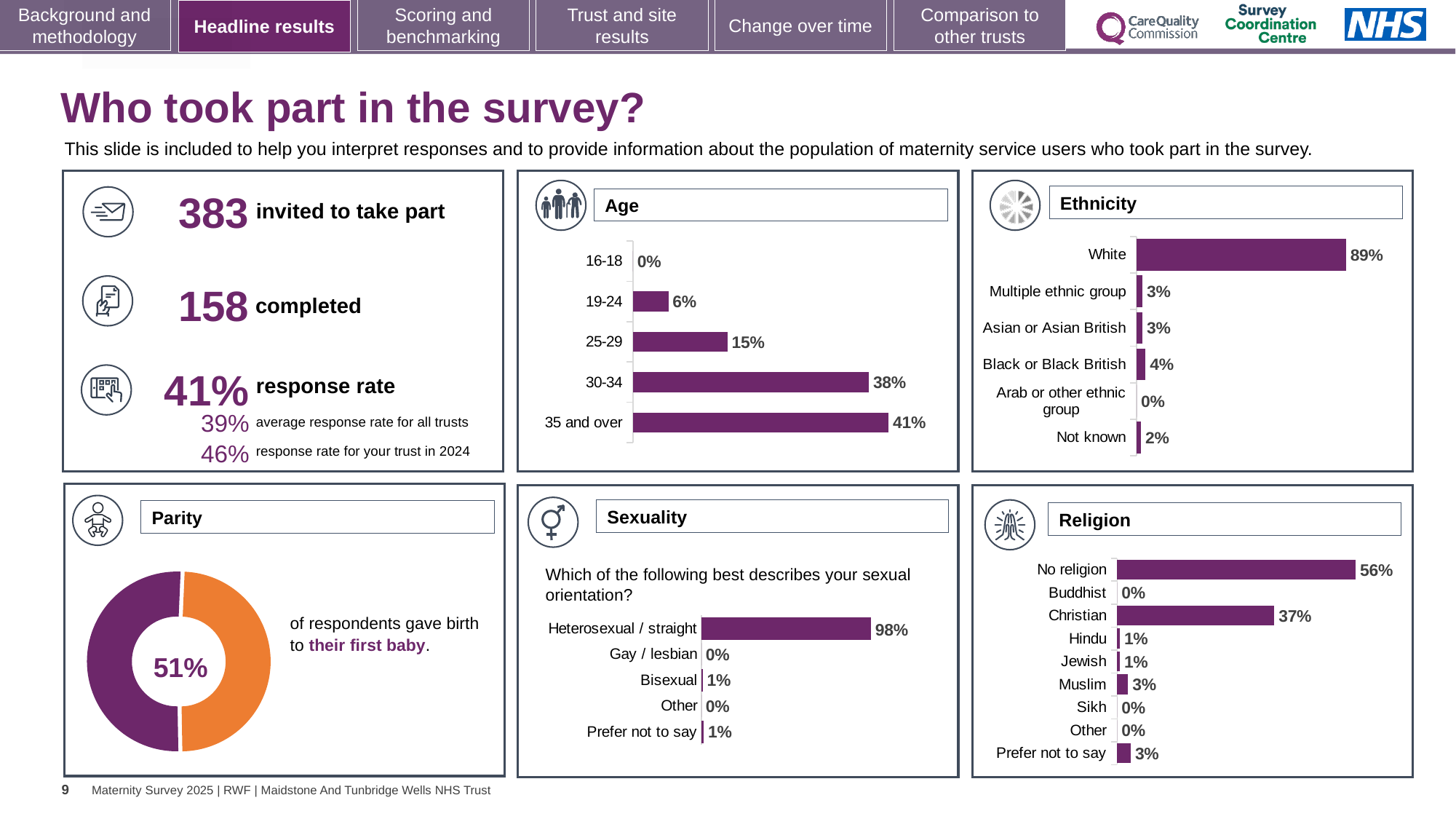
In the Parity chart, what percentage of respondents gave birth to their first baby? 51% In the Age chart, how many age categories are shown? 5 In the Ethnicity chart, what is the difference between the percentages for White and Black or Black British? 85% In the Religion chart, which category has the highest percentage? No religion In the Religion chart, how many religion categories are listed? 9 In the Sexuality chart, what percentage of respondents answered Heterosexual / straight? 98% In the Age chart, what percentage of respondents were aged 30-34? 38% In the Age chart, which age group has the highest percentage? 35 and over In the Ethnicity chart, what percentage of respondents were White? 89% What kind of chart is the Parity chart? Pie chart (doughnut) In the Ethnicity chart, which is larger: Black or Black British or Not known? Black or Black British In the Religion chart, what is the difference between No religion and Christian? 19%